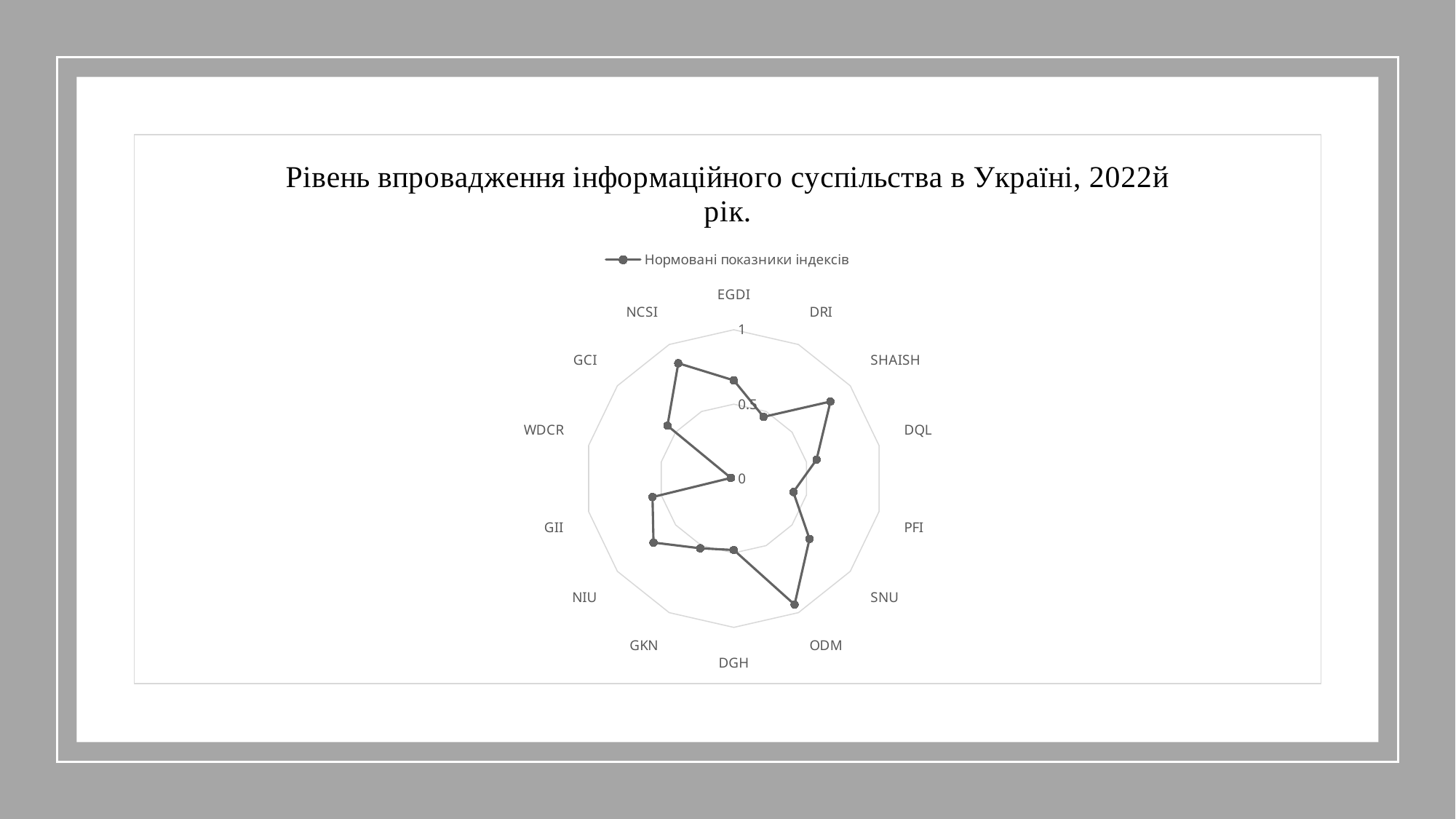
What kind of chart is shown on the slide? Radar chart How many series does the legend list? 1 Is the value for ODM greater or less than 0.5? greater Which is larger, the value for ODM or the value for PFI? ODM Is the value for PFI greater or less than 0.5? less What is the title of the chart? Рівень впровадження інформаційного суспільства в Україні, 2022й рік. Is the value for NCSI greater or less than 0.5? greater What is the name of the series shown in the legend? Нормовані показники індексів Which category has the lowest value on the chart? WDCR How many categories (indices) are plotted on the radar chart? 14 Which is larger, the value for NIU or the value for DRI? NIU